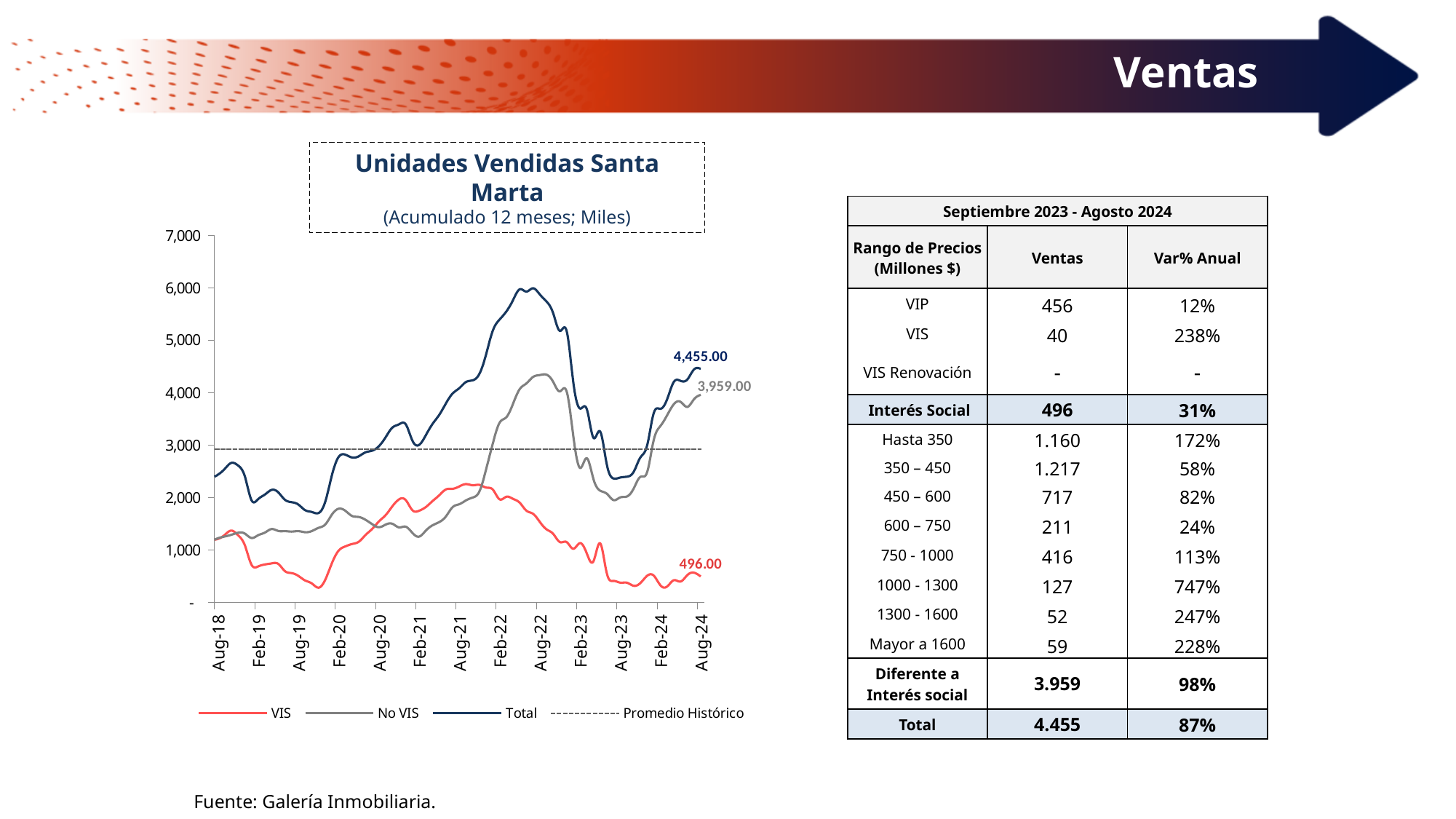
What kind of chart is shown on the slide? Line chart At Aug-24, which is larger: the No VIS value or the VIS value? No VIS Does the Total series rise or fall between Aug-23 and Aug-24? Rises What is the value of the No VIS series at Aug-24? 3,959.00 Which series has the highest value at Aug-24? Total Is the value of the Total series at Aug-22 greater or less than 5,000? greater What is the value of the Total series at Aug-24 in the Unidades Vendidas Santa Marta chart? 4,455.00 Is the value of the VIS series at Aug-23 greater or less than 1,000? less What is the value of the VIS series at Aug-24? 496.00 What is the title of the chart? Unidades Vendidas Santa Marta How many series does the legend of the chart list? 4 What is the difference between the Total and No VIS values at Aug-24? 496.00